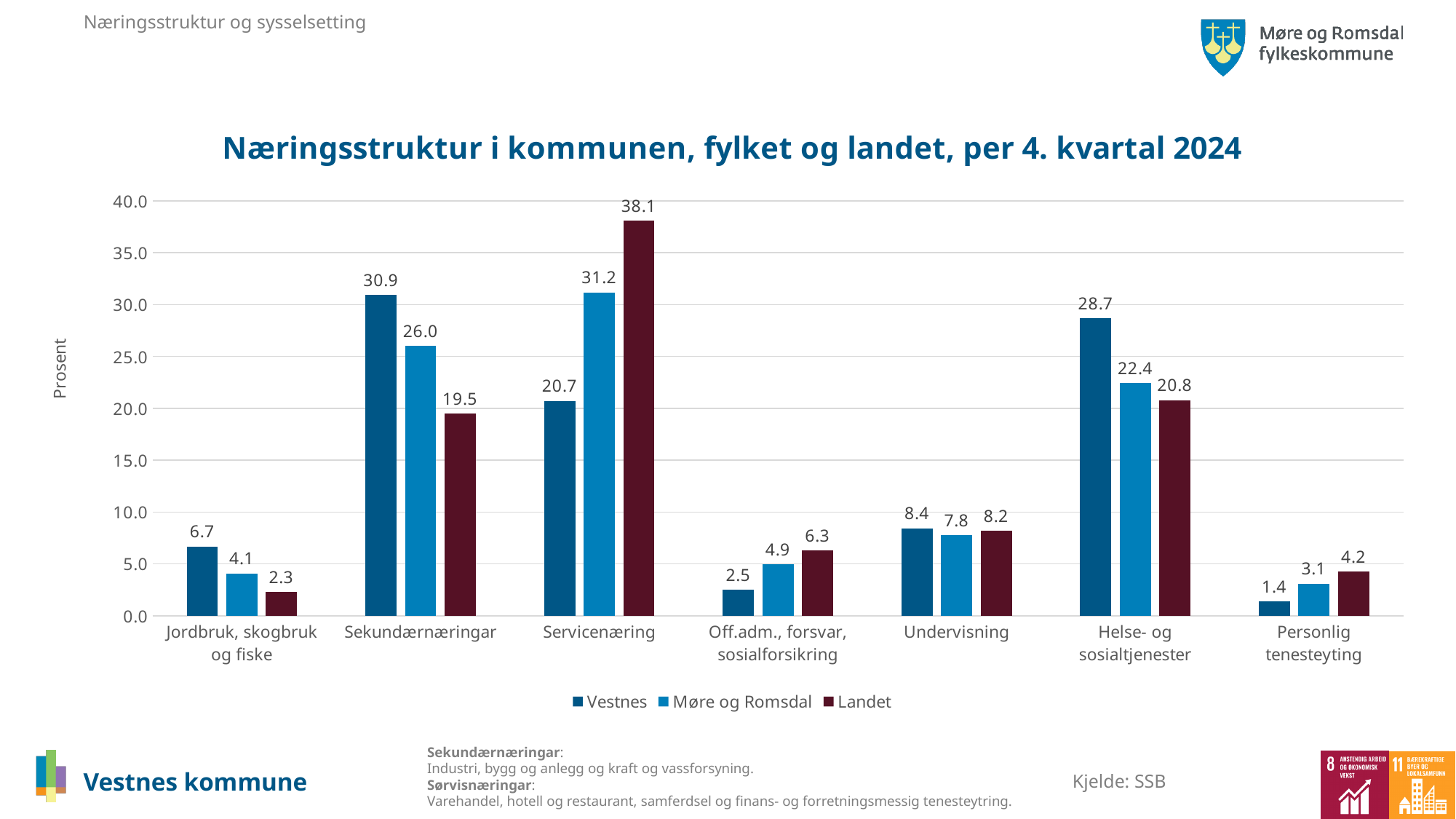
How many categories are shown on the x axis? 7 What is the value for Landet in the Servicenæring category? 38.1 What is the difference between the Landet and Vestnes values in the Servicenæring category? 17.4 What is the value for Møre og Romsdal in the Helse- og sosialtjenester category? 22.4 What is the value for Vestnes in the Sekundærnæringar category? 30.9 Is the value for Vestnes in the Helse- og sosialtjenester category greater or less than 25.0? greater Which category has the lowest value for Landet? Jordbruk, skogbruk og fiske How many series does the legend list? 3 What is the title of the chart? Næringsstruktur i kommunen, fylket og landet, per 4. kvartal 2024 Which is larger in the Undervisning category: the value for Vestnes or the value for Møre og Romsdal? Vestnes What kind of chart is shown on the slide? Bar chart Which category has the highest value for Vestnes? Sekundærnæringar